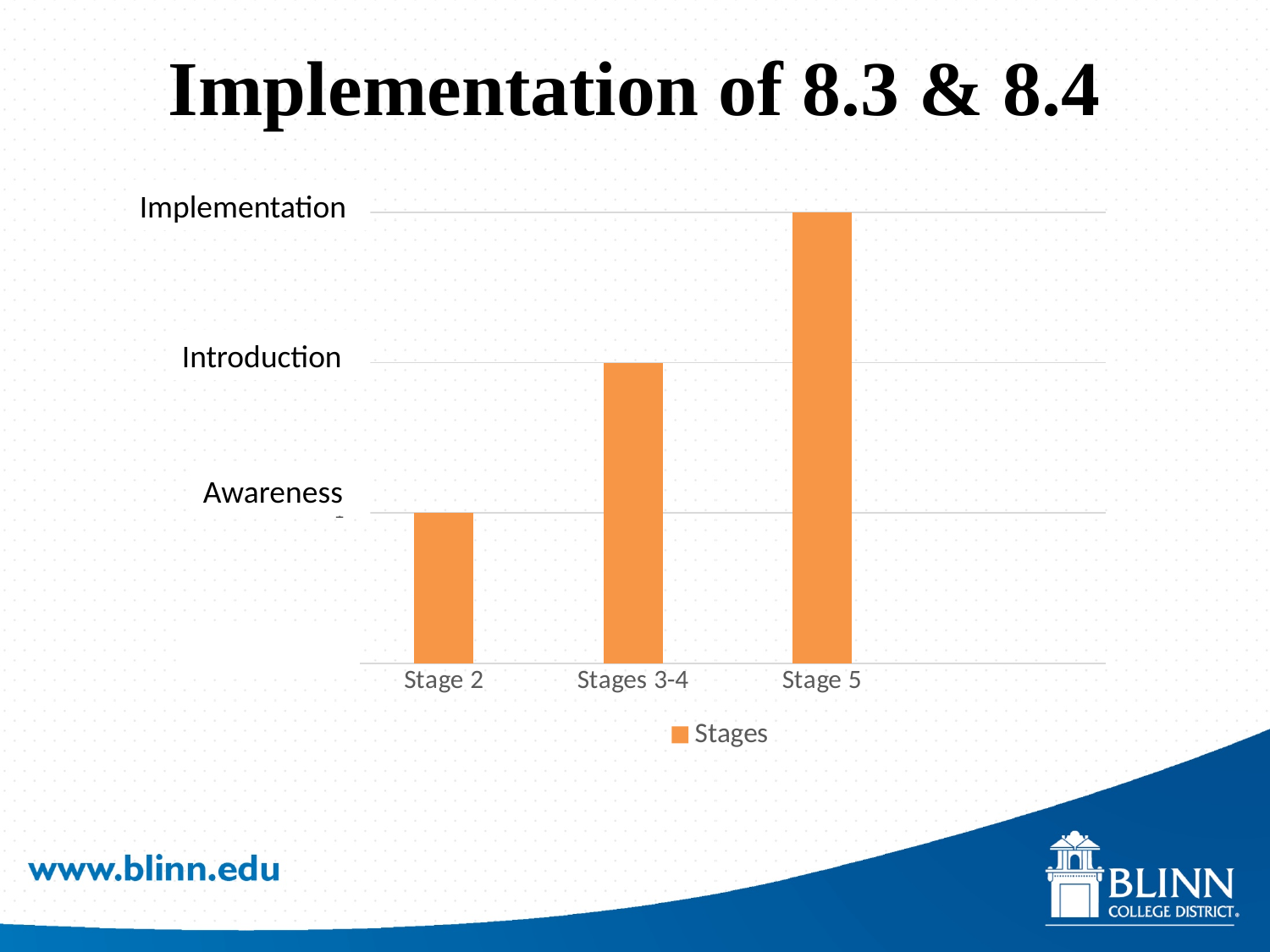
What is the title of the slide containing the chart? Implementation of 8.3 & 8.4 Which level on the y axis does the bar for Stage 2 reach? Awareness Which level on the y axis does the bar for Stage 5 reach? Implementation How many series does the chart legend list? 1 What kind of chart is shown on the slide? Bar chart Which category has the shortest bar? Stage 2 Which bar is taller, Stage 2 or Stages 3-4? Stages 3-4 Which level on the y axis does the bar for Stages 3-4 reach? Introduction Which category has the tallest bar? Stage 5 Do the bar heights rise or fall from Stage 2 to Stage 5 along the x axis? Rise What is the name of the series shown in the chart legend? Stages How many categories are shown on the x axis of the chart? 3